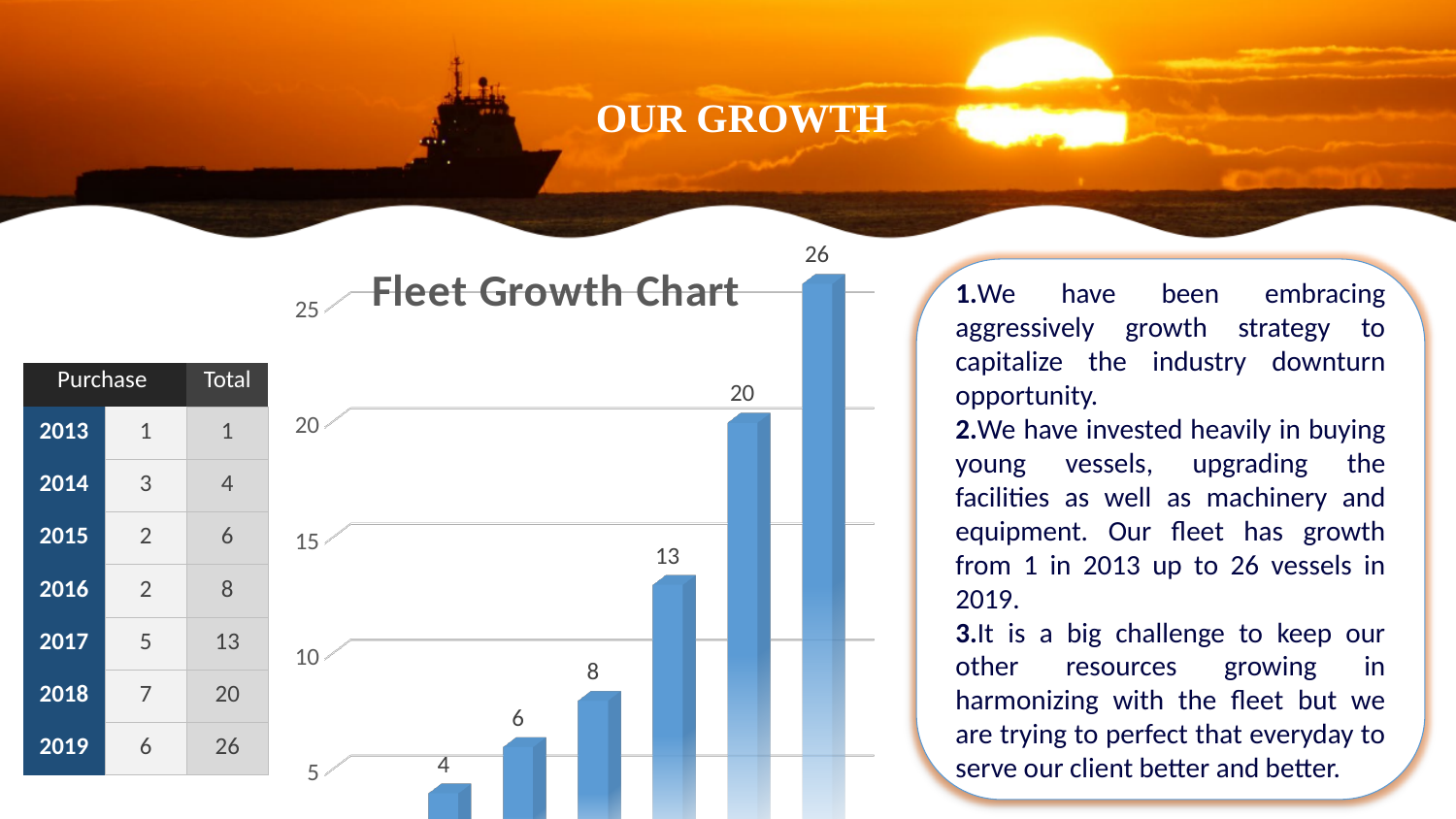
What is the lowest value labelled on a bar in the Fleet Growth Chart? 4 How many bars with data labels are shown in the Fleet Growth Chart? 6 Is the value of the tallest bar in the Fleet Growth Chart greater or less than 25? greater What is the title of the chart on the slide? Fleet Growth Chart In the Fleet Growth Chart, what is the difference between the tallest bar (26) and the second tallest bar (20)? 6 Do the bar values in the Fleet Growth Chart rise or fall from left to right? rise What kind of chart is the Fleet Growth Chart? bar chart In the Fleet Growth Chart, what is the value labelled on the second bar from the left? 6 In the Fleet Growth Chart, which is larger: the third bar from the left or the fourth bar from the left? the fourth bar (13) In the Fleet Growth Chart, what is the value labelled on the fourth bar from the left? 13 What is the highest value labelled on a bar in the Fleet Growth Chart? 26 In the Fleet Growth Chart, what is the difference between the bar labelled 13 and the bar labelled 8? 5